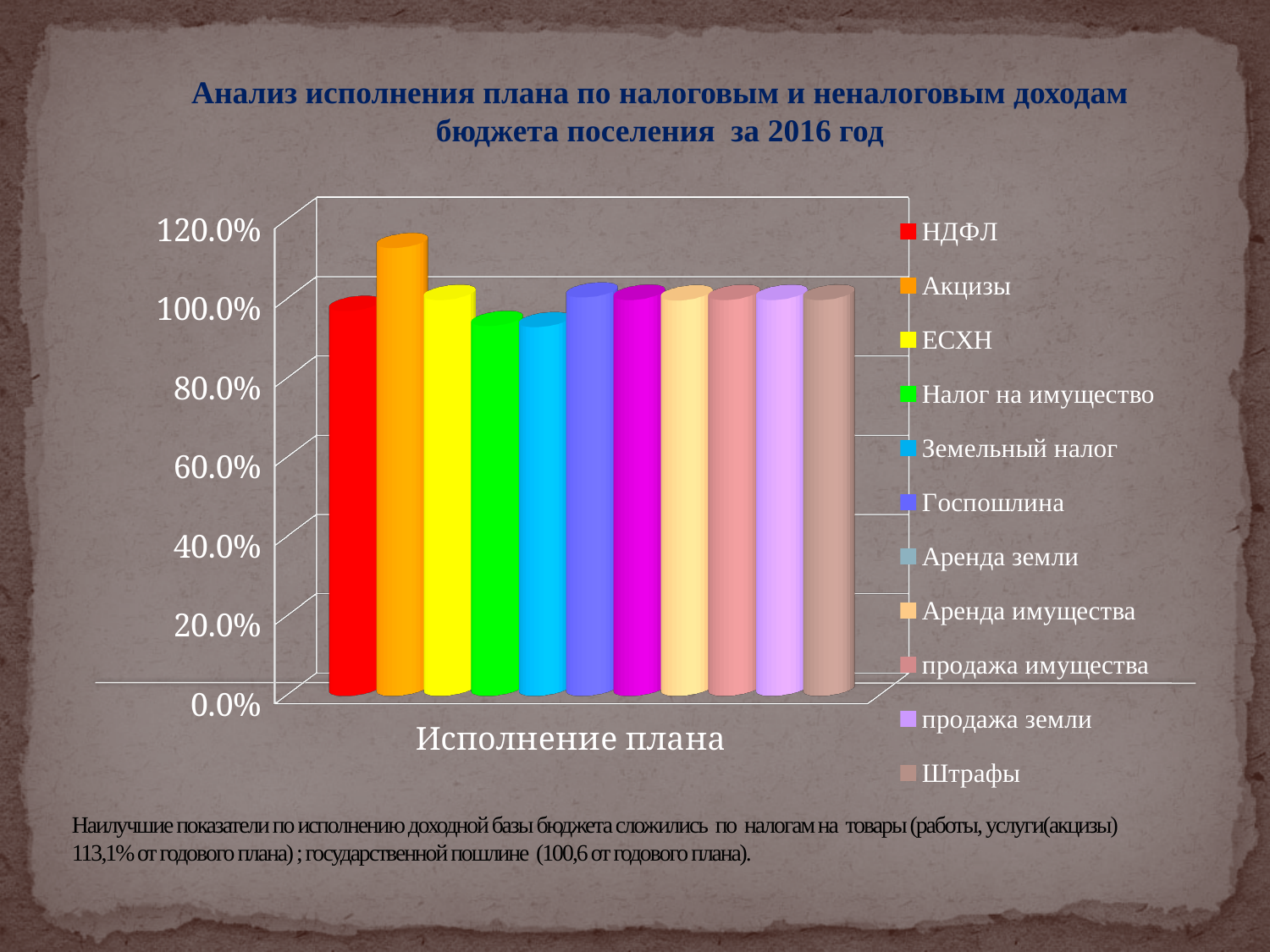
How many series does the legend list? 11 Is the value for Акцизы greater or less than 100.0%? greater Which is larger, the value for ЕСХН or the value for Земельный налог? ЕСХН Which series has the highest bar? Акцизы What colour is the bar for НДФЛ? red Which is larger, the value for Акцизы or the value for НДФЛ? Акцизы Is the value for Земельный налог greater or less than 100.0%? less Which series has the lowest bar? Земельный налог What is the label shown on the x axis of the chart? Исполнение плана What kind of chart is shown on the slide? bar chart How many categories are shown on the x axis? 1 Is the value for Налог на имущество greater or less than 100.0%? less